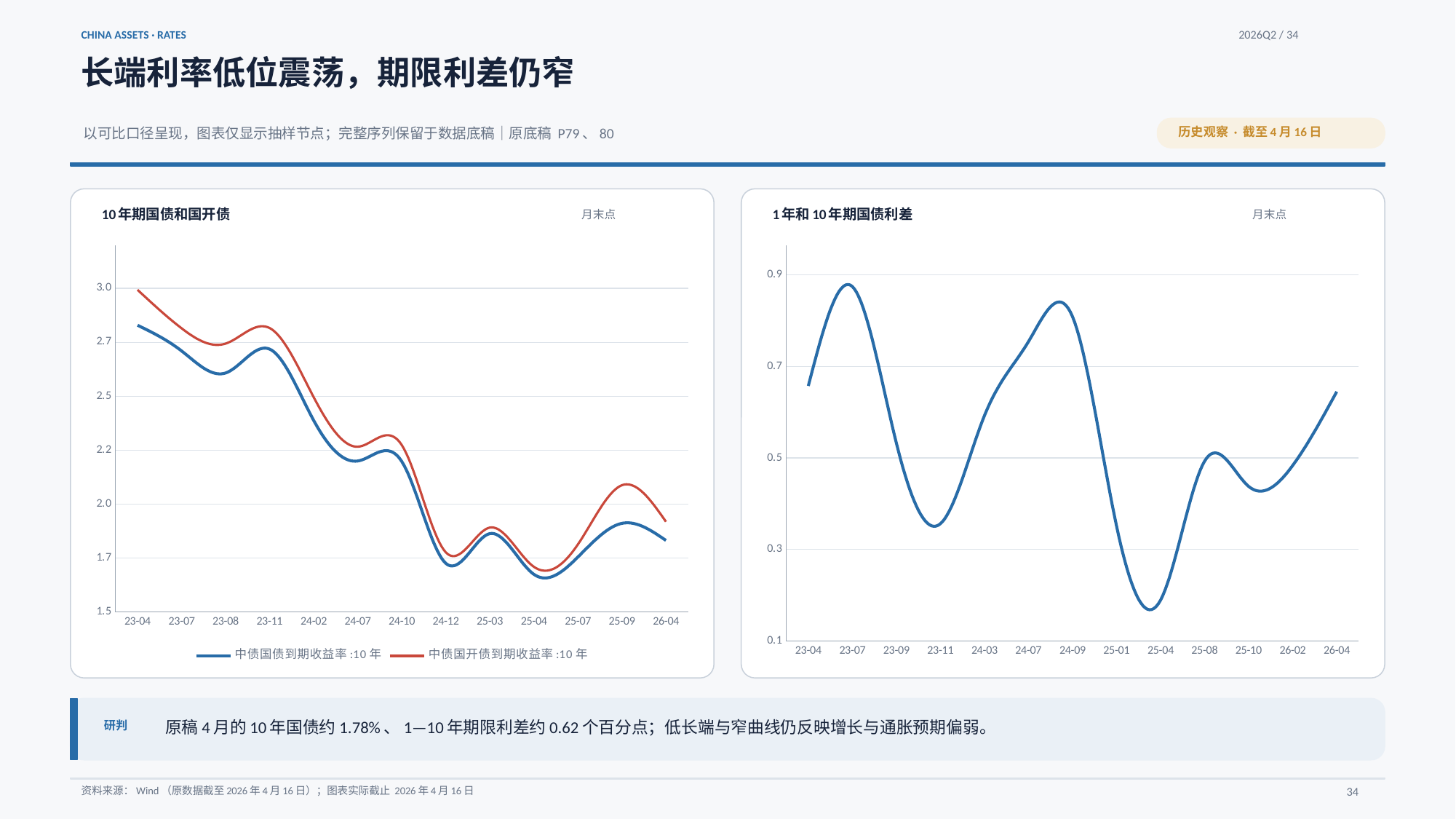
On the left chart (10年期国债和国开债), which series is higher at 23-04? 中债国开债到期收益率:10年 How many x-axis points are shown on the left chart (10年期国债和国开债)? 13 On the right chart (1年和10年期国债利差), at which x-axis point is the value lowest? 25-04 What kind of chart is the left chart titled 10年期国债和国开债? line chart On the left chart (10年期国债和国开债), is the value of 中债国债到期收益率:10年 at 25-04 greater or less than 1.7? less What kind of chart is the right chart titled 1年和10年期国债利差? line chart On the left chart (10年期国债和国开债), is the value of 中债国开债到期收益率:10年 at 23-04 greater or less than 2.7? greater On the left chart (10年期国债和国开债), does 中债国债到期收益率:10年 overall rise or fall from 23-04 to 26-04? fall On the left chart (10年期国债和国开债), what colour is the line for 中债国债到期收益率:10年? blue How many x-axis points are shown on the right chart (1年和10年期国债利差)? 13 On the right chart (1年和10年期国债利差), is the value at 23-07 greater or less than 0.7? greater How many series does the legend of the left chart (10年期国债和国开债) list? 2